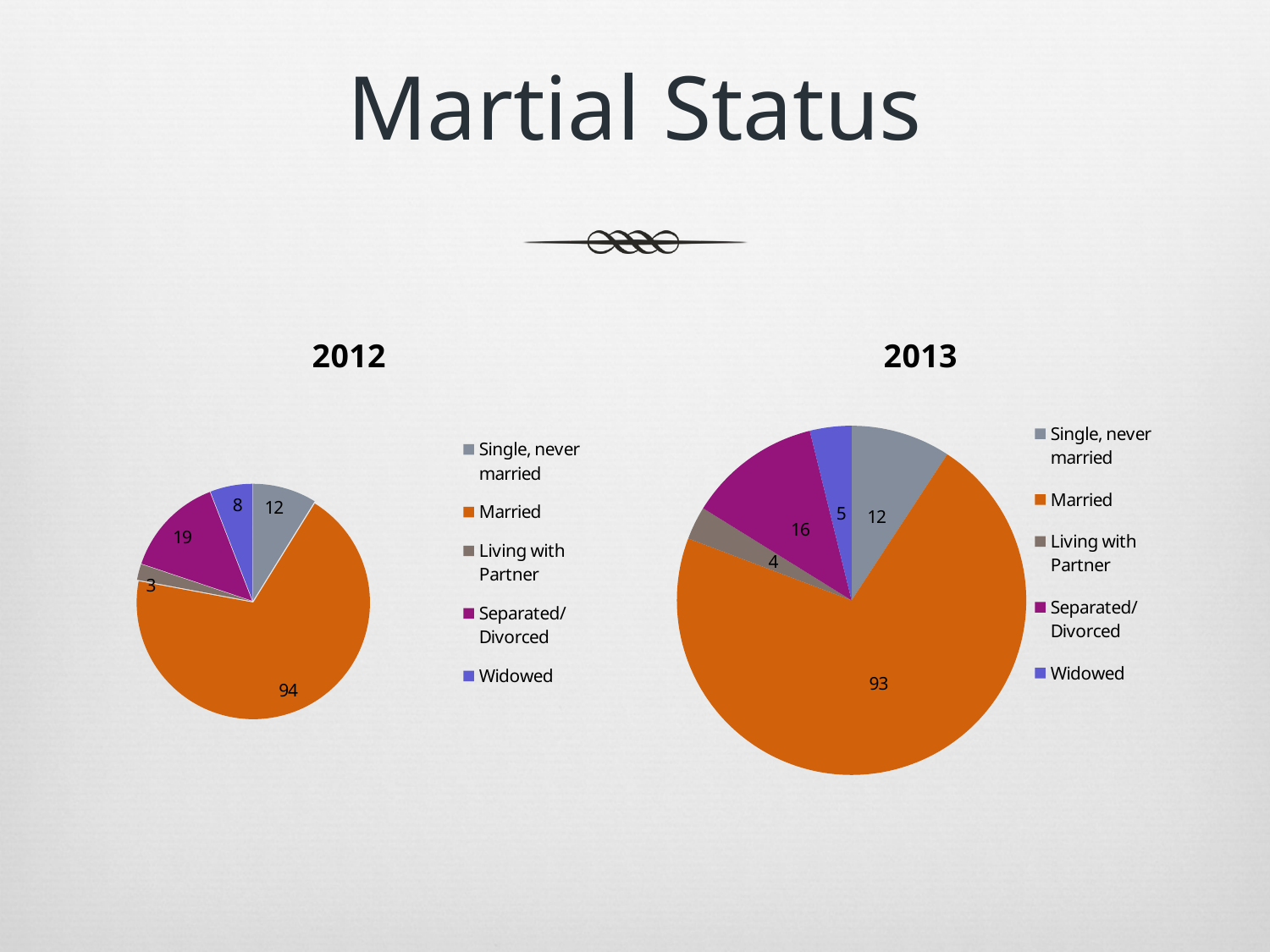
What is the difference between the Separated/Divorced values in the 2012 and 2013 charts? 3 What kind of chart is the 2012 chart? Pie chart In the 2013 chart, what is the value for Separated/Divorced? 16 In the 2012 chart, which is larger: Widowed or Single, never married? Single, never married In the 2013 chart, what is the difference between Married and Single, never married? 81 In the 2012 chart, what is the value for Married? 94 What colour is the Married slice in the 2013 chart? Orange In the 2012 chart, what is the value for Living with Partner? 3 How many categories does the 2013 chart show? 5 In the 2013 chart, what is the value for Widowed? 5 In the 2012 chart, which category has the smallest slice? Living with Partner In the 2013 chart, which category has the largest slice? Married